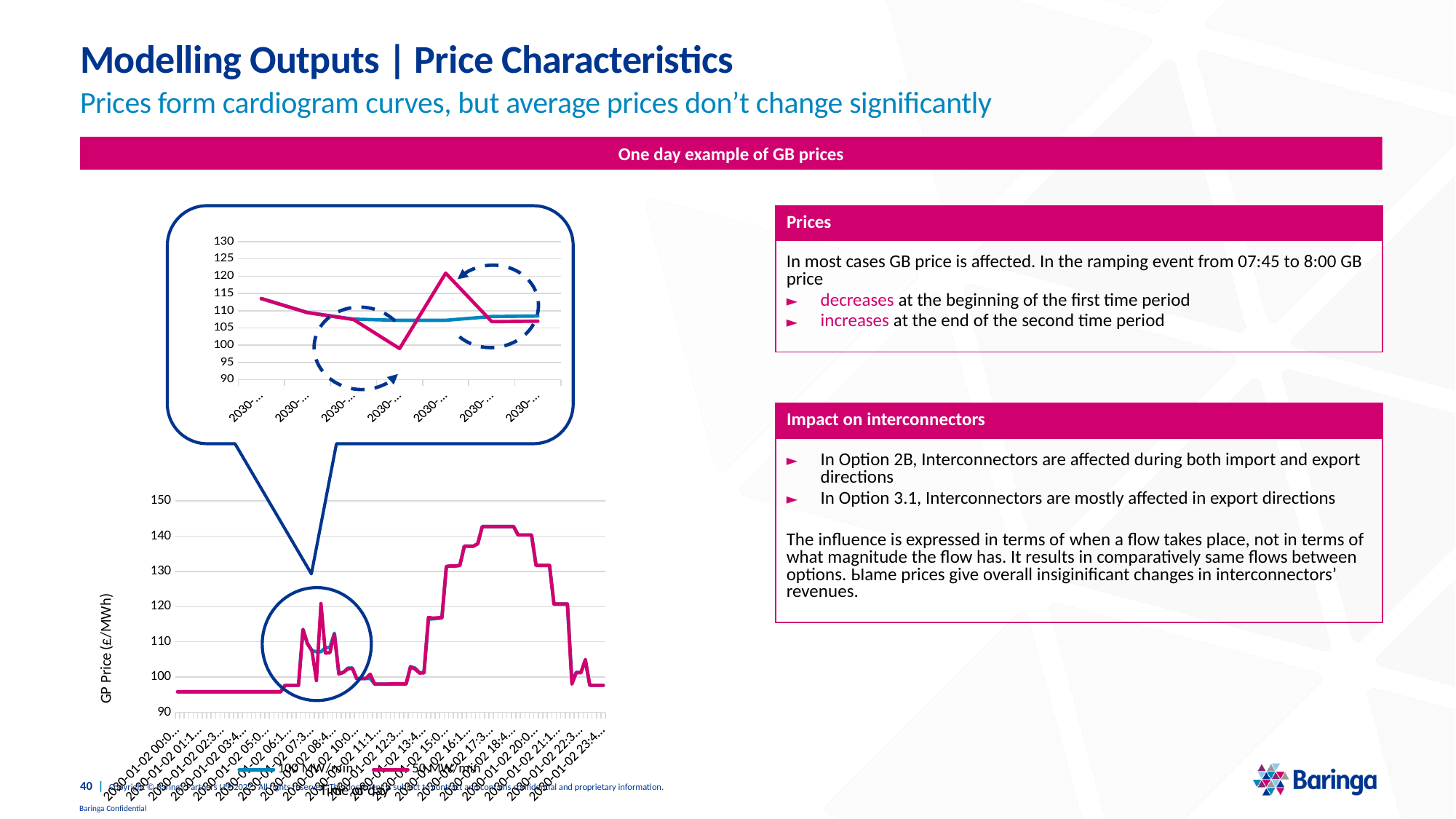
In the main chart, is the highest value of the 50 MW/min series greater or less than 140? greater In the zoomed-in inset chart, which series shows the larger swing in values, 100 MW/min or 50 MW/min? 50 MW/min In the zoomed-in inset chart, is the peak value of the 50 MW/min series greater or less than 115? greater What is the maximum value shown on the y-axis of the main chart? 150 What is the y-axis label of the main chart? GP Price (£/MWh) In the main chart, is the value of the 50 MW/min series at the end of the day (around 23:45) greater or less than 100? less What kind of chart is the large chart at the bottom left of the slide? Line chart How many series does the legend of the main chart list? 2 What is the title shown in the banner above the charts? One day example of GB prices